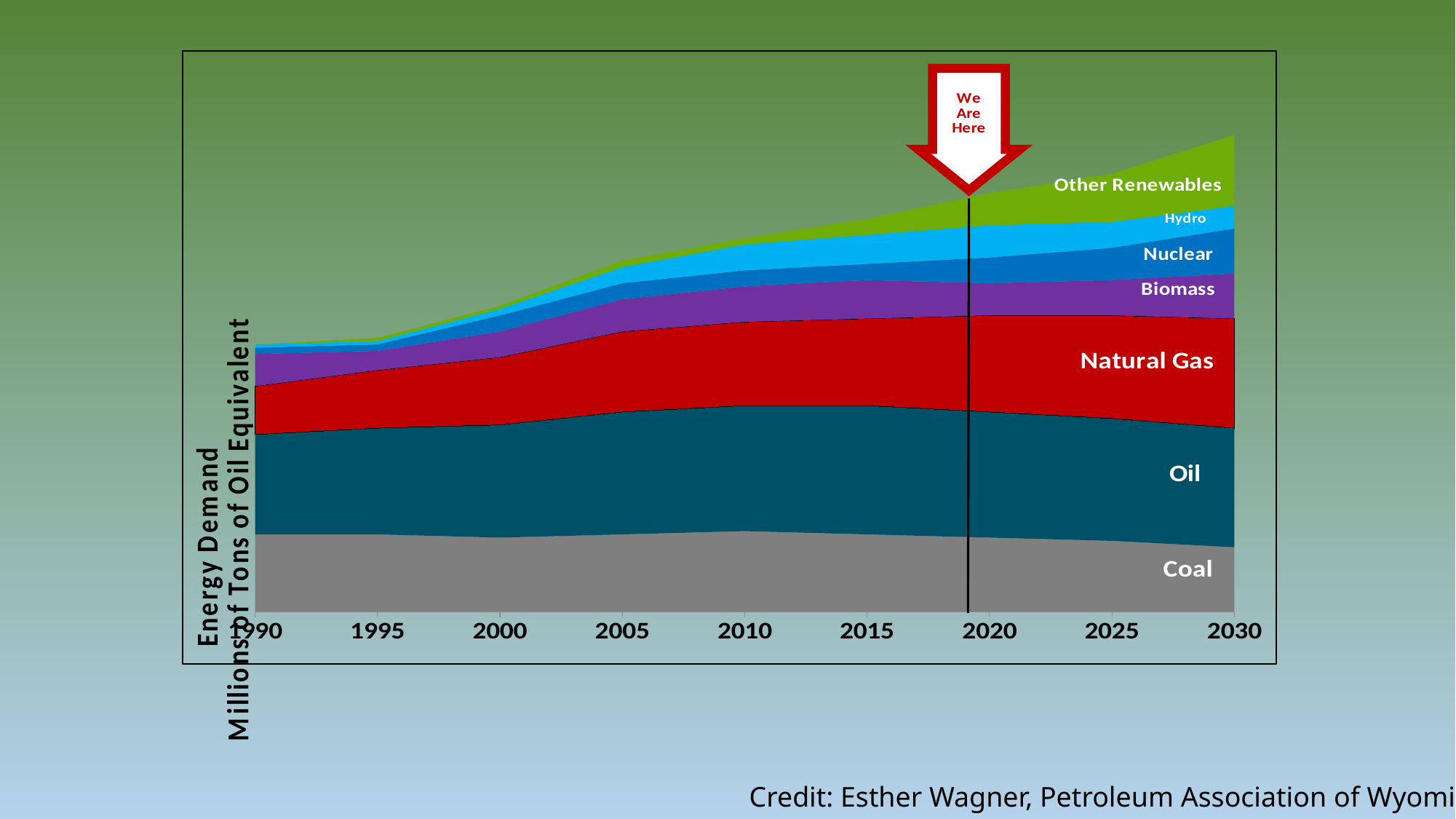
Which energy source has the thinnest band in 2030? Hydro Does the Other Renewables band grow or shrink between 2020 and 2030? Grow Which energy source forms the top layer of the stacked area chart? Other Renewables How many energy sources (series) are labelled in the chart? 7 What is the first year shown on the x axis? 1990 What kind of chart is shown on the slide? Stacked area chart Which band is thicker in 2030, Natural Gas or Biomass? Natural Gas How many year labels are shown along the x axis? 9 Does total energy demand rise or fall from 1990 to 2030? Rise Which energy source forms the bottom layer of the stacked area chart? Coal Which energy source has the thickest band in 2030? Oil What is the last year shown on the x axis? 2030